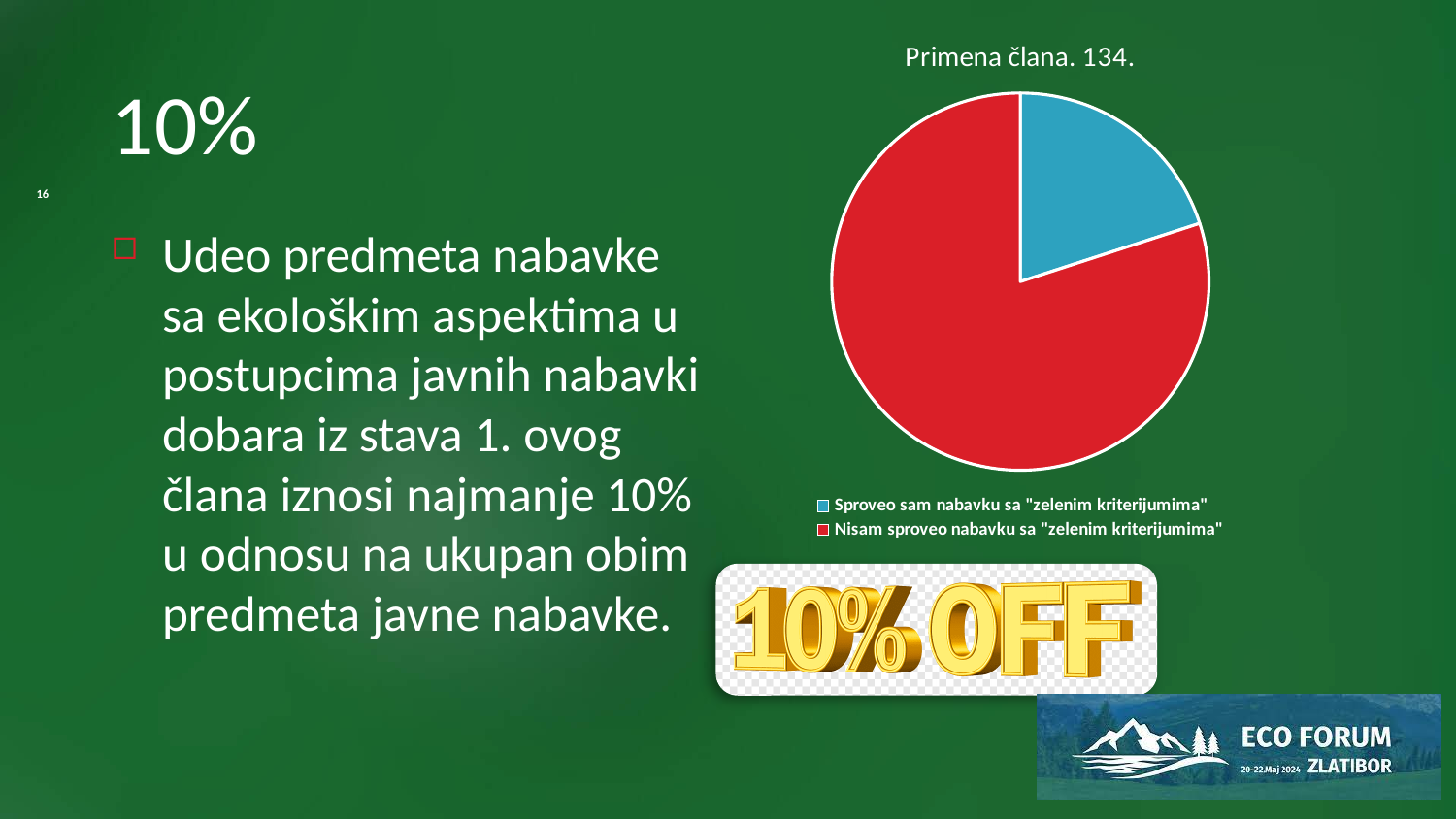
Which category has the largest slice of the pie? Nisam sproveo nabavku sa "zelenim kriterijumima" What kind of chart is shown on the slide? pie chart How many slices does the pie chart have? 2 How many entries does the chart legend list? 2 Which slice is larger: "Sproveo sam nabavku sa 'zelenim kriterijumima'" or "Nisam sproveo nabavku sa 'zelenim kriterijumima'"? Nisam sproveo nabavku sa "zelenim kriterijumima" Which category has the smallest slice of the pie? Sproveo sam nabavku sa "zelenim kriterijumima" What is the title of the chart? Primena člana. 134. What colour is the slice for "Sproveo sam nabavku sa 'zelenim kriterijumima'"? blue